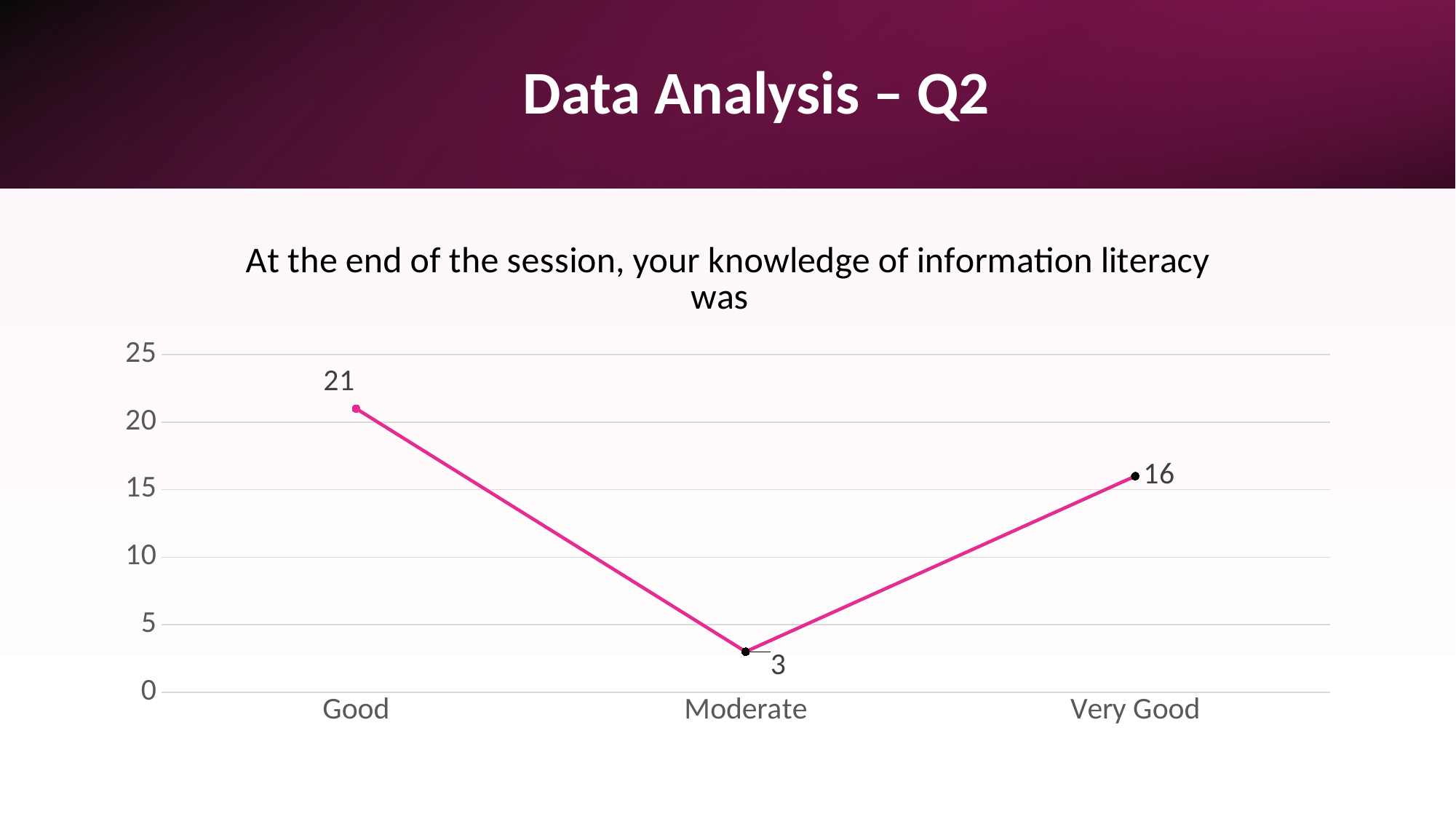
What is the difference between the values for Very Good and Moderate? 13 Is the value for Very Good greater or less than 20? less What is the value for Good? 21 How many categories are shown on the x axis? 3 What is the value for Very Good? 16 What is the value for Moderate? 3 Which category has the highest value? Good What kind of chart is shown on the slide? line chart What is the title of the chart? At the end of the session, your knowledge of information literacy was Which is larger, the value for Good or the value for Very Good? Good What is the difference between the values for Good and Very Good? 5 Which category has the lowest value? Moderate